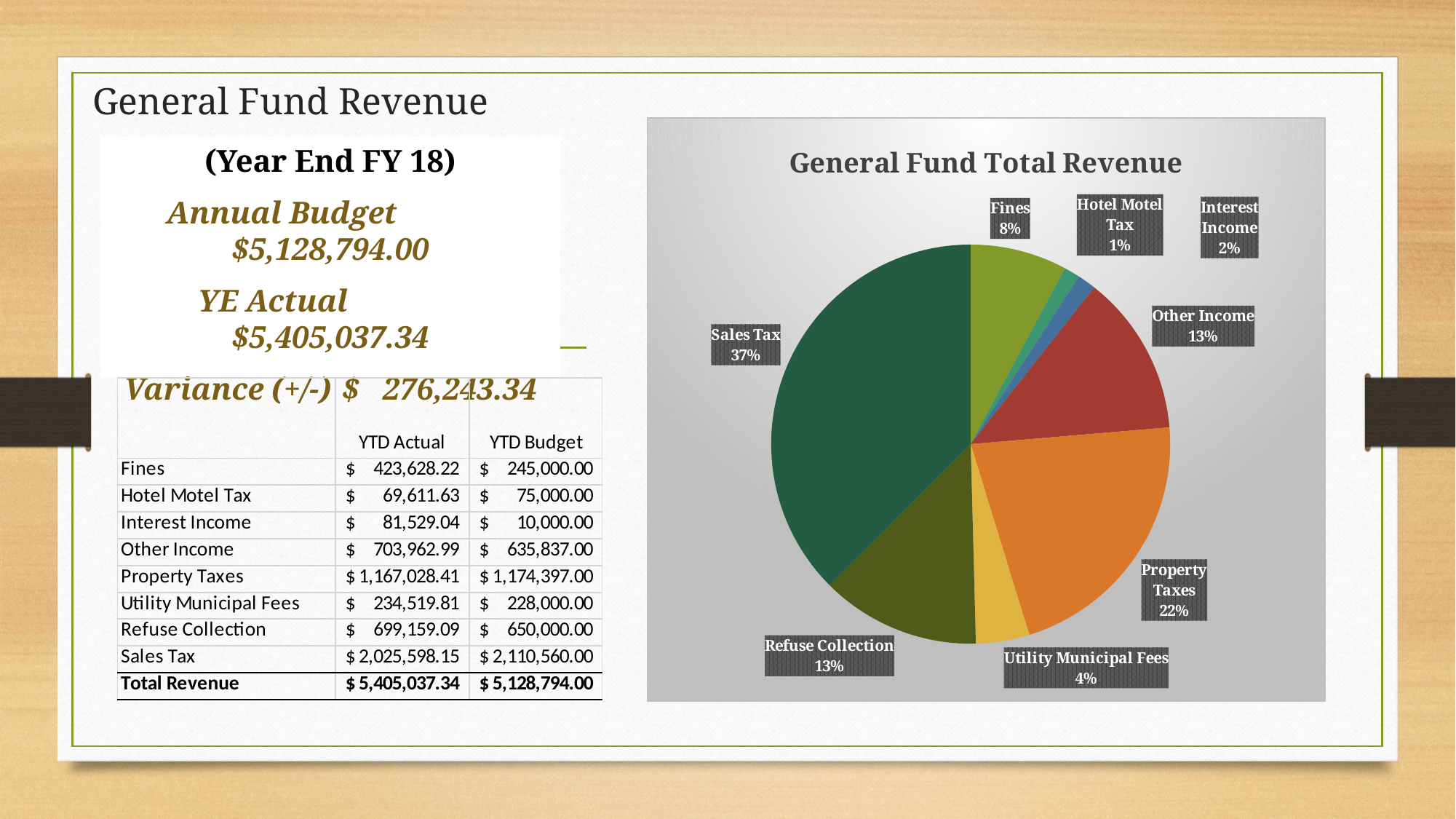
Which category has the largest slice of the pie? Sales Tax How many slices does the pie chart have? 8 What share of the pie does Sales Tax represent? 37% What percentage is shown for Utility Municipal Fees in the pie chart? 4% What kind of chart is shown on the slide? Pie chart Which category has the smallest slice of the pie? Hotel Motel Tax What percentage is shown for Fines in the pie chart? 8% What share of the pie does Property Taxes represent? 22% What is the title of the chart? General Fund Total Revenue Which is larger, the share for Fines or the share for Interest Income? Fines What is the difference in percentage points between Sales Tax and Property Taxes? 15 What percentage is shown for Refuse Collection in the pie chart? 13%